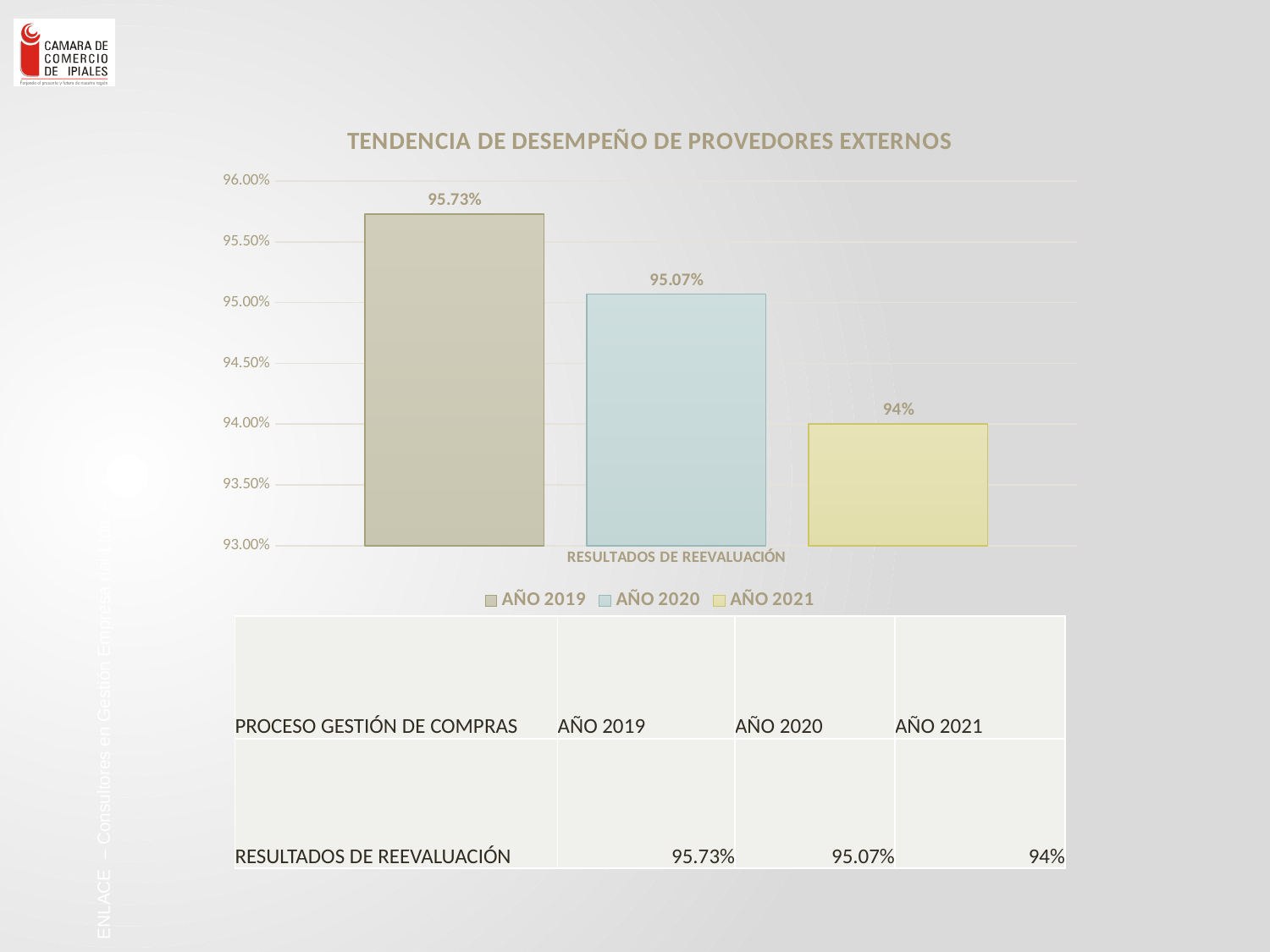
What is the difference between the values for AÑO 2019 and AÑO 2020? 0.66% What is the value for AÑO 2021 in the chart? 94% Is the value for AÑO 2020 greater or less than 95.00%? greater Which is larger, the value for AÑO 2020 or the value for AÑO 2021? AÑO 2020 What is the value for AÑO 2019 in the chart? 95.73% What is the difference between the values for AÑO 2020 and AÑO 2021? 1.07% Which year has the lowest value in the chart? AÑO 2021 What kind of chart is shown on the slide? bar chart Do the values rise or fall from AÑO 2019 to AÑO 2021? fall Which year has the highest value in the chart? AÑO 2019 How many series does the legend list? 3 What is the value for AÑO 2020 in the chart? 95.07%